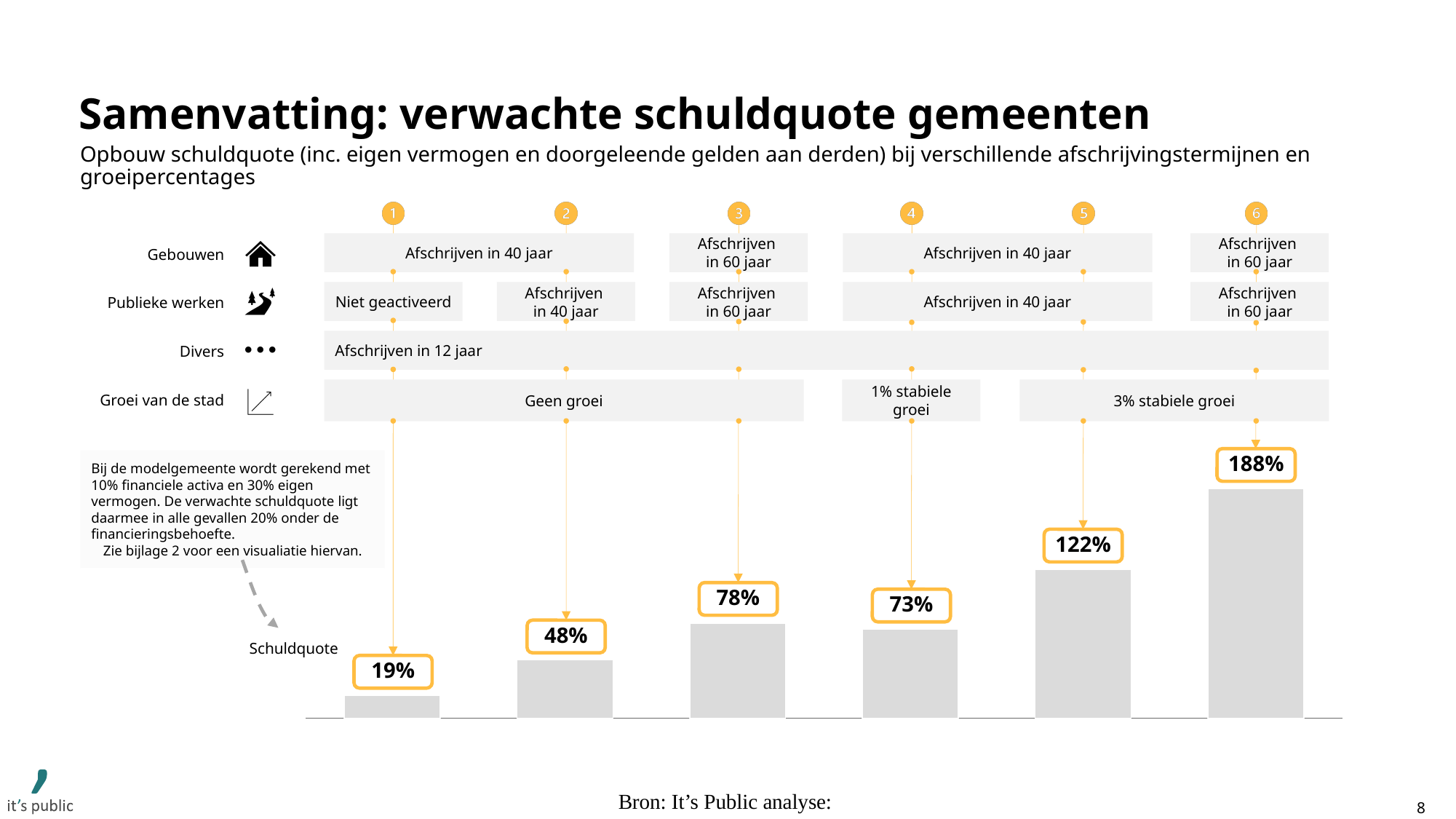
What is the difference between the schuldquote of scenario 5 and scenario 4? 49% Which scenario has the highest schuldquote? Scenario 6 What is the schuldquote for scenario 4? 73% Which has a larger schuldquote, scenario 3 or scenario 4? Scenario 3 What is the difference between the schuldquote of scenario 2 and scenario 1? 29% What is the depreciation period for 'Divers' across all scenarios? Afschrijven in 12 jaar What kind of chart is used to show the schuldquote? Bar chart What growth assumption applies to scenarios 5 and 6? 3% stabiele groei How many scenarios (bars) are shown in the chart? 6 Which scenario has the lowest schuldquote? Scenario 1 What is the schuldquote for scenario 6? 188% What is the schuldquote for scenario 1? 19%